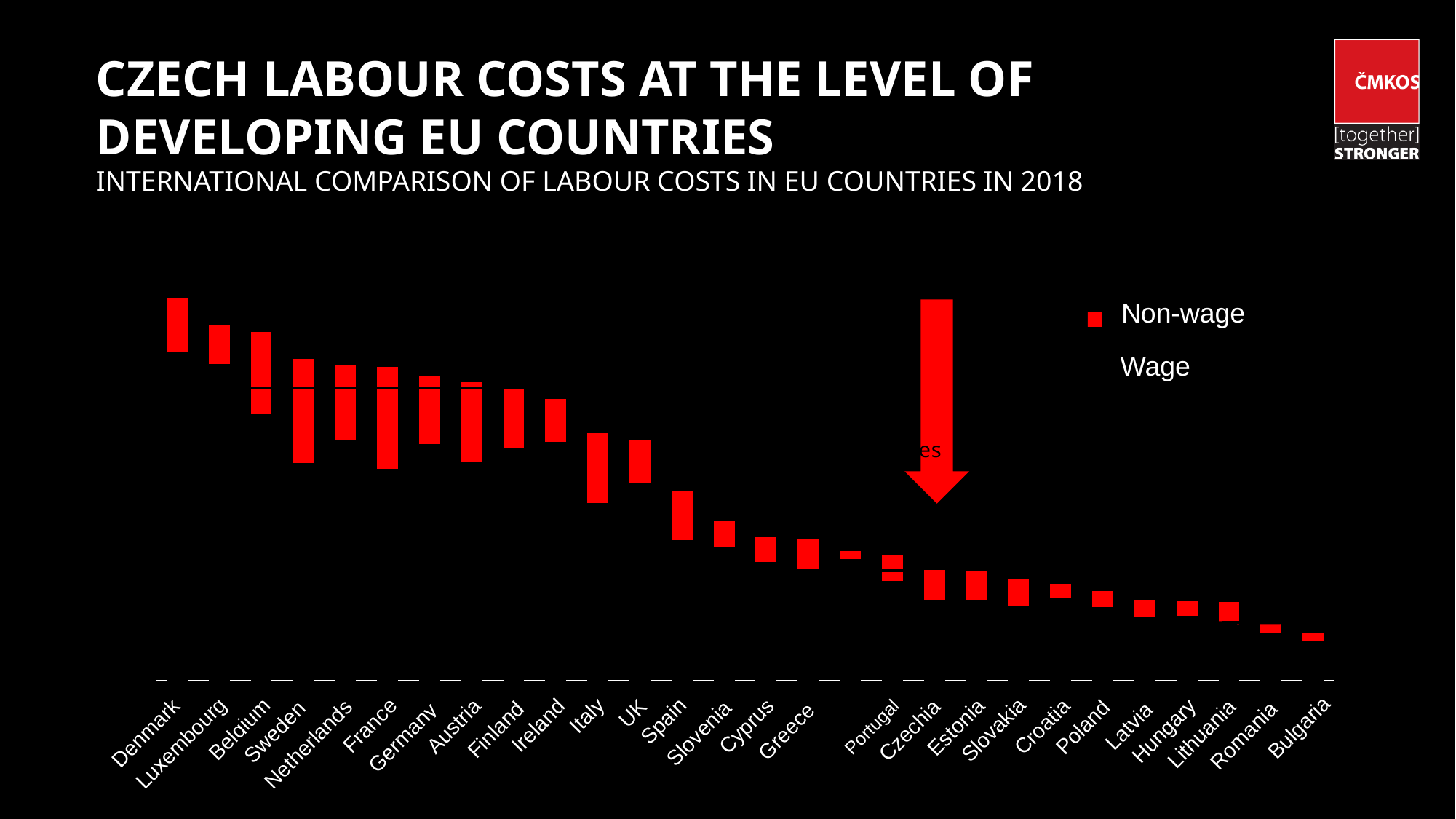
What are the two series named in the chart legend? Non-wage and Wage Which country has the higher labour cost bar, Luxembourg or Poland? Luxembourg Which country has the higher labour cost bar, Sweden or Czechia? Sweden How many countries are shown on the x axis of the chart? 27 Which country has the lowest labour cost bar in the chart? Bulgaria What kind of chart is shown on the slide? Bar chart Which country is the first (leftmost) category on the x axis? Denmark Do the labour cost bars rise or fall moving from left to right along the x axis? Fall How many series does the chart legend list? 2 Which country has the higher labour cost bar, Romania or Italy? Italy Which country has the highest labour cost bar in the chart? Denmark